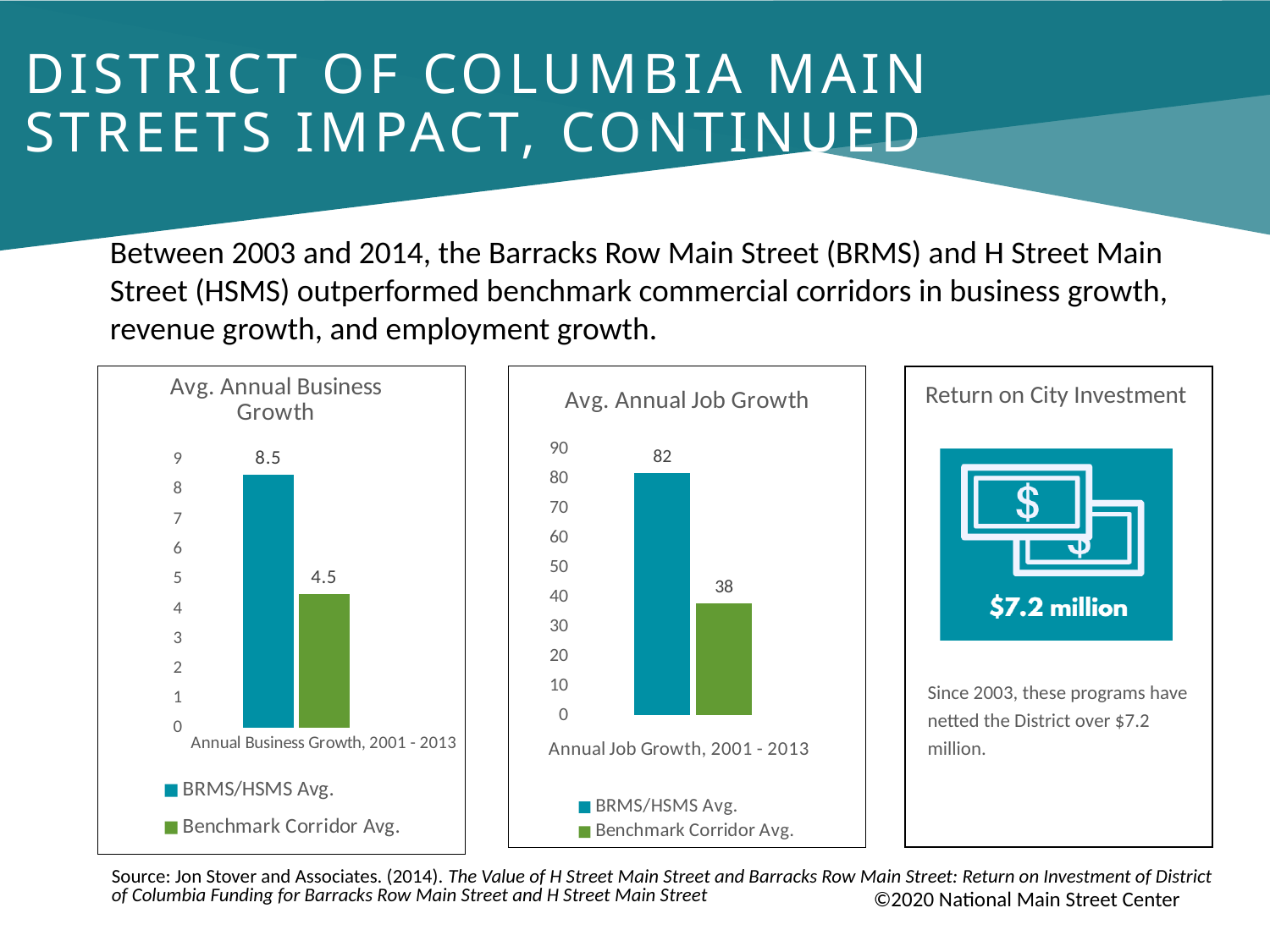
In the 'Avg. Annual Job Growth' chart, is the value for Benchmark Corridor Avg. greater or less than 40? less What is the x-axis category label in the 'Avg. Annual Job Growth' chart? Annual Job Growth, 2001 - 2013 In the 'Avg. Annual Business Growth' chart, what is the value for Benchmark Corridor Avg.? 4.5 In the 'Avg. Annual Job Growth' chart, what is the difference between the BRMS/HSMS Avg. and the Benchmark Corridor Avg.? 44 In the 'Avg. Annual Business Growth' chart, what is the difference between the BRMS/HSMS Avg. and the Benchmark Corridor Avg.? 4 In the 'Avg. Annual Business Growth' chart, which series has the lowest value? Benchmark Corridor Avg. In the 'Avg. Annual Job Growth' chart, which series has the higher value? BRMS/HSMS Avg. What kind of chart is the 'Avg. Annual Job Growth' chart? Bar chart How many series does the legend of the 'Avg. Annual Business Growth' chart list? 2 In the 'Avg. Annual Job Growth' chart, what is the value for BRMS/HSMS Avg.? 82 In the 'Avg. Annual Business Growth' chart, what is the value for BRMS/HSMS Avg.? 8.5 In the 'Avg. Annual Job Growth' chart, what is the value for Benchmark Corridor Avg.? 38